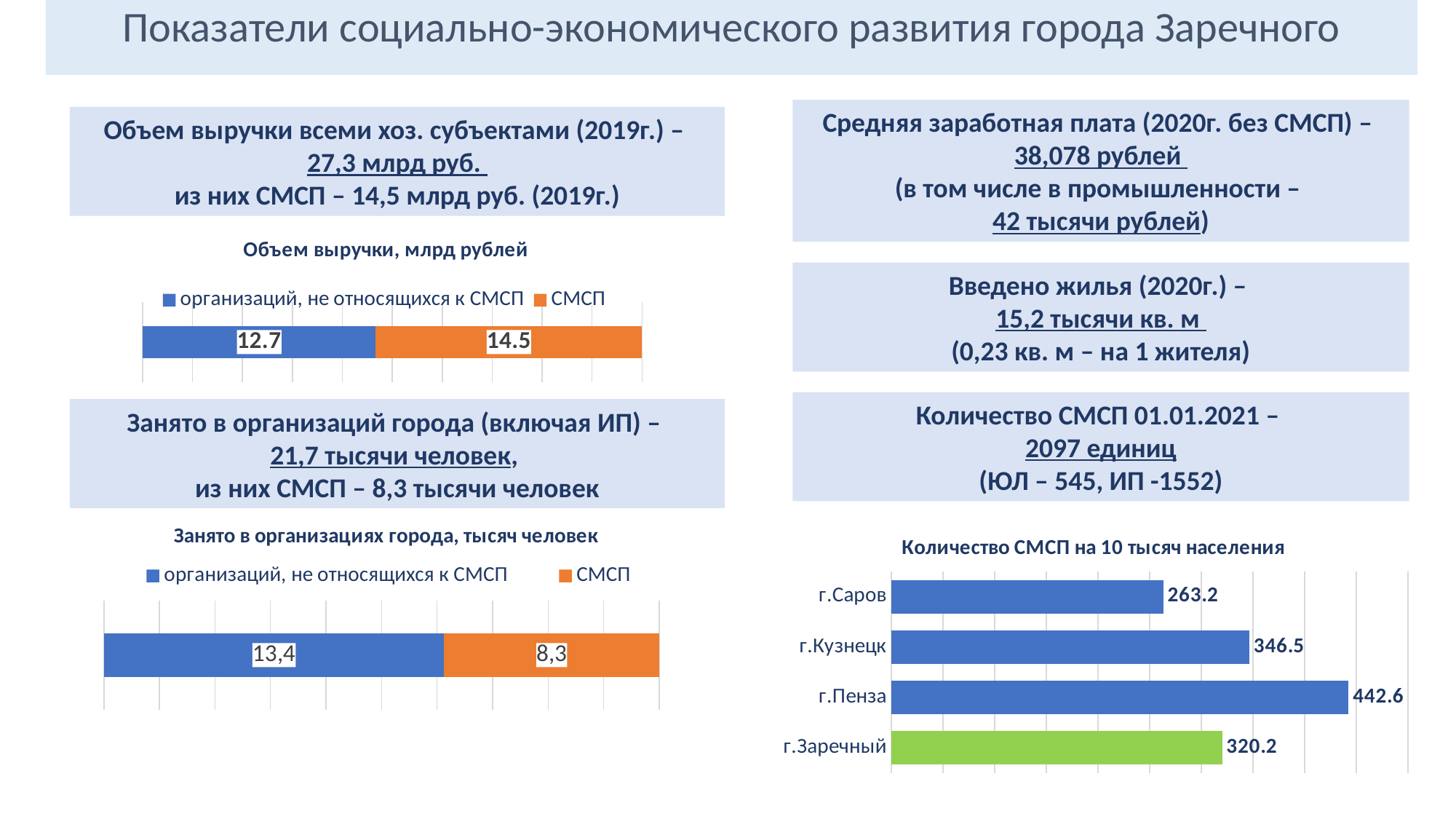
In the chart 'Количество СМСП на 10 тысяч населения', which is larger: г.Кузнецк or г.Заречный? г.Кузнецк In the chart 'Количество СМСП на 10 тысяч населения', which city has the highest value? г.Пенза In the chart 'Количество СМСП на 10 тысяч населения', what is the value for г.Заречный? 320.2 In the chart 'Количество СМСП на 10 тысяч населения', what is the value for г.Пенза? 442.6 How many series does the legend of the chart 'Занято в организациях города, тысяч человек' list? 2 How many cities are shown in the chart 'Количество СМСП на 10 тысяч населения'? 4 In the chart 'Объем выручки, млрд рублей', what is the value for СМСП? 14.5 In the chart 'Объем выручки, млрд рублей', what is the total of the stacked bar? 27.2 In the chart 'Количество СМСП на 10 тысяч населения', which city has the lowest value? г.Саров In the chart 'Занято в организациях города, тысяч человек', what is the value for организаций, не относящихся к СМСП? 13,4 What type of chart is 'Количество СМСП на 10 тысяч населения'? Bar chart In the chart 'Количество СМСП на 10 тысяч населения', what is the difference between г.Кузнецк and г.Саров? 83.3